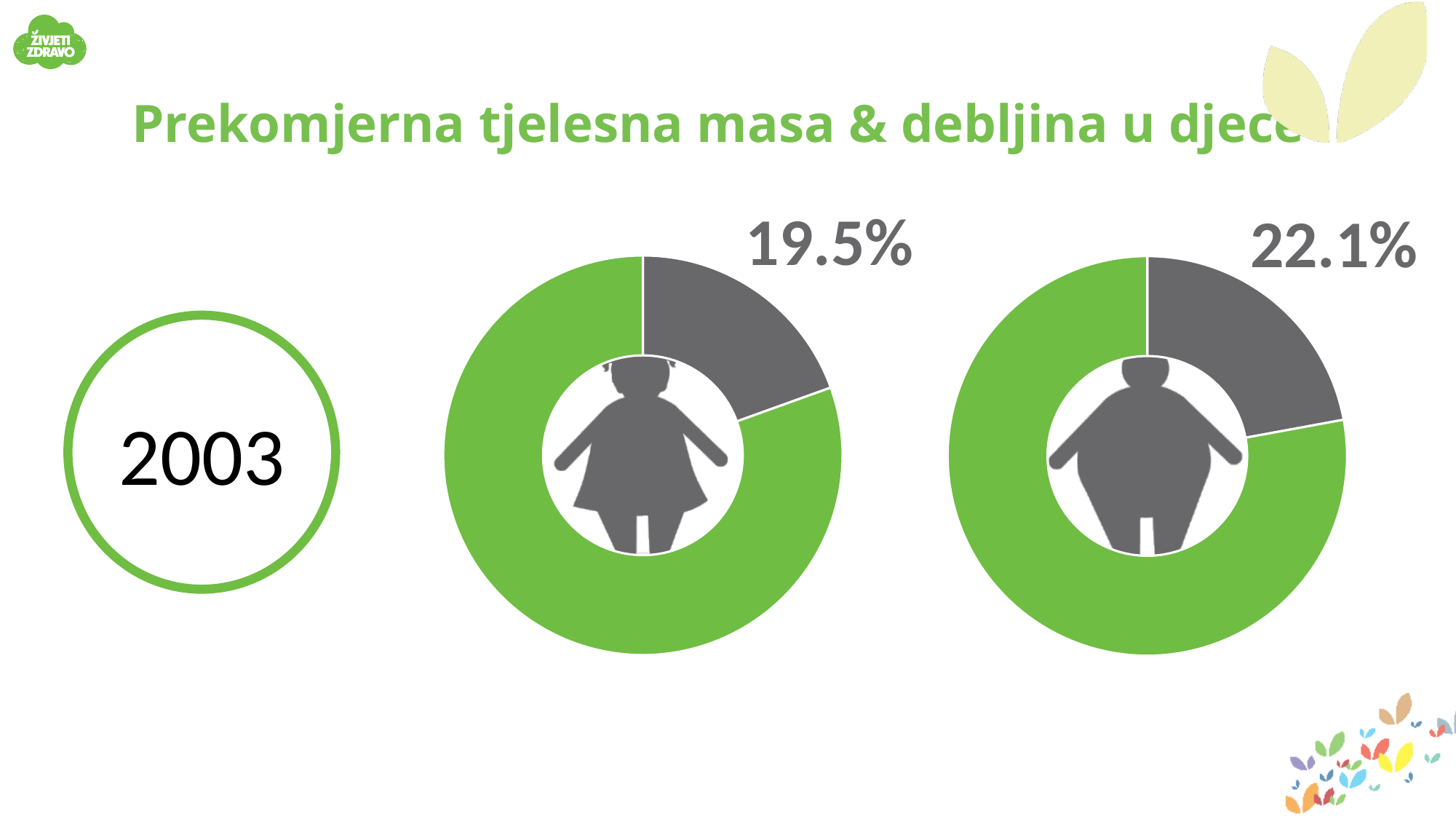
What percentage is labelled on the left donut chart (with the girl figure)? 19.5% What percentage is labelled on the right donut chart (with the boy figure)? 22.1% Which of the two donut charts shows the larger labelled percentage, the left one or the right one? the right one What is the title of the slide? Prekomjerna tjelesna masa & debljina u djece What is the difference between the percentage on the right donut chart and the percentage on the left donut chart? 2.6 percentage points What kind of charts are shown on the slide? donut (pie) charts On the right donut chart, what share of the ring is taken by the grey segment? 22.1% Which donut chart has the smaller grey segment, the left one or the right one? the left one On the left donut chart, what share of the ring is taken by the grey segment? 19.5% What year is shown in the circle on the left of the slide? 2003 How many donut charts are on the slide? 2